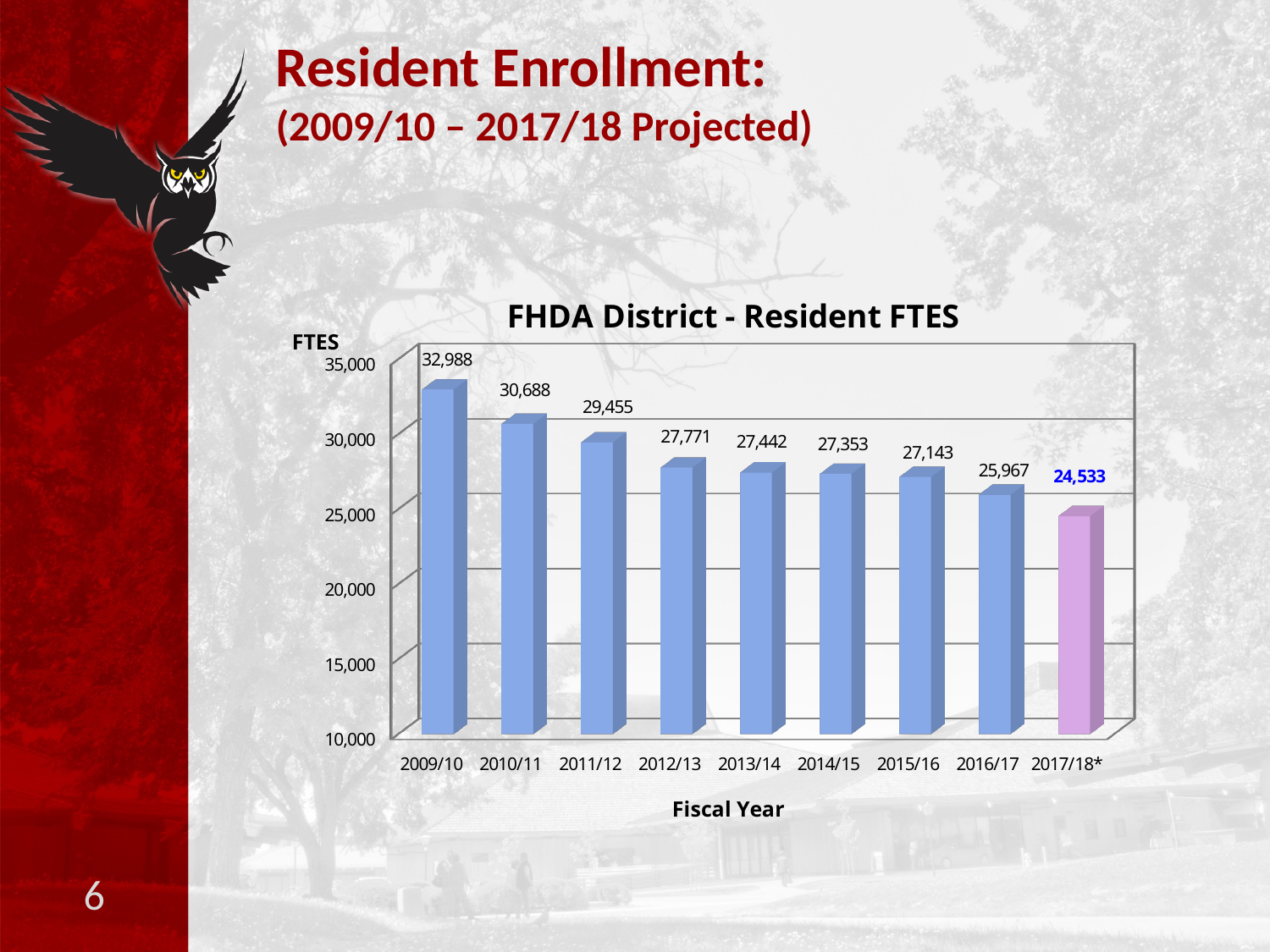
Do the Resident FTES values rise or fall from 2009/10 to 2017/18*? Fall What is the Resident FTES value for 2013/14? 27,442 Which fiscal year has the highest Resident FTES? 2009/10 Is the Resident FTES value for 2015/16 greater or less than 25,000? greater What is the difference in Resident FTES between 2009/10 and 2017/18*? 8,455 What kind of chart is shown on the slide? Bar chart What is the difference in Resident FTES between 2010/11 and 2011/12? 1,233 Which fiscal year has the lowest Resident FTES? 2017/18* How many fiscal years are shown on the x axis of the chart? 9 Which has a larger Resident FTES value, 2012/13 or 2016/17? 2012/13 What is the Resident FTES value for 2009/10? 32,988 What is the Resident FTES value for 2017/18*? 24,533